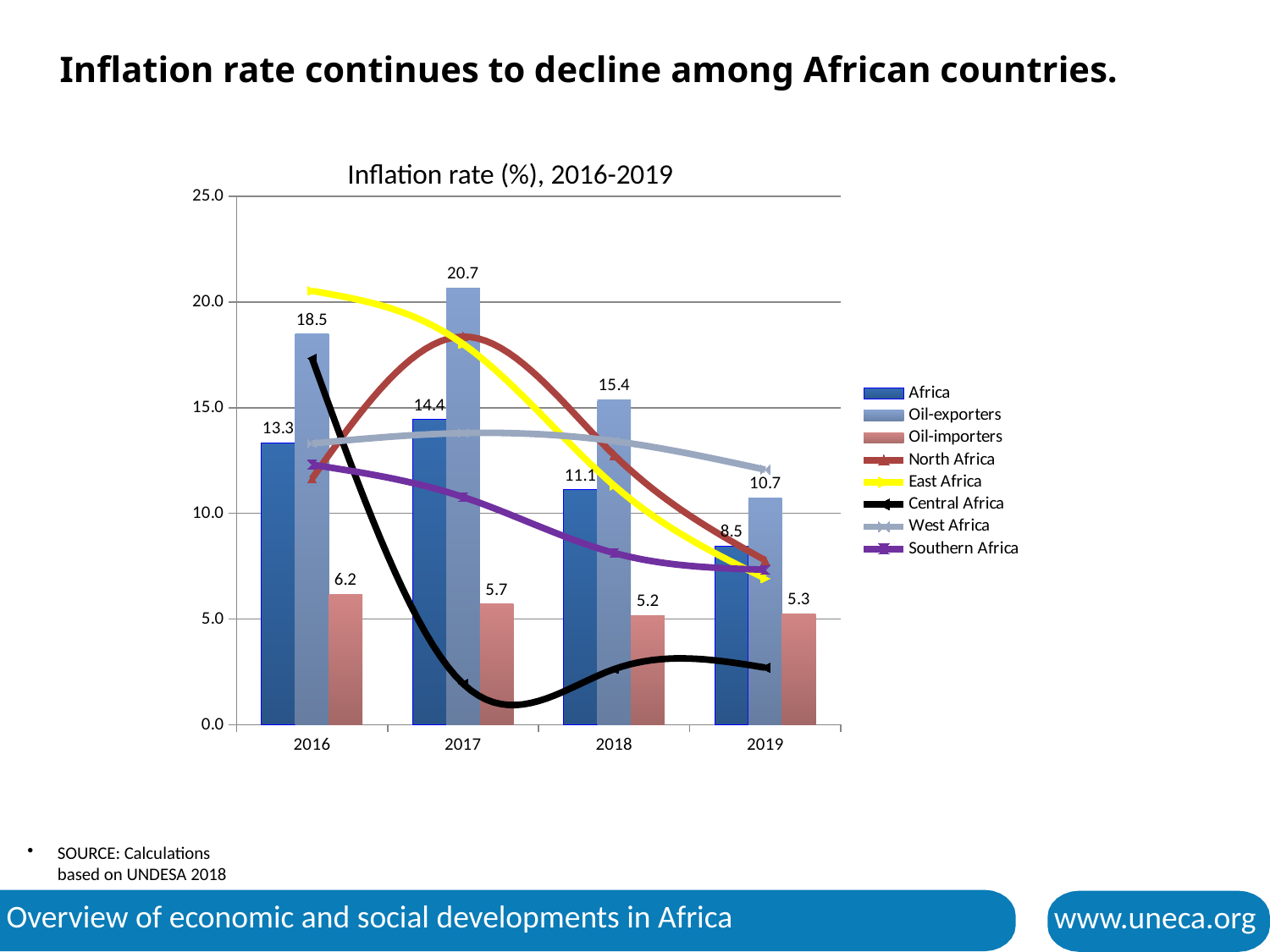
In which year is the Oil-importers bar lowest? 2018 What is the difference between the Oil-exporters and Africa values in 2017? 6.3 In which year is the Oil-exporters bar highest? 2017 Do the Africa bars rise or fall from 2017 to 2019? fall Which is larger, the Africa value in 2016 or in 2018? 2016 Is the East Africa value in 2016 greater or less than 20.0? greater What is the inflation rate for Africa in 2019? 8.5 What is the inflation rate for Oil-importers in 2016? 6.2 What is the inflation rate for Oil-exporters in 2017? 20.7 How many years are shown on the x axis? 4 Is the Central Africa value in 2017 greater or less than 5.0? less How many series does the legend list? 8